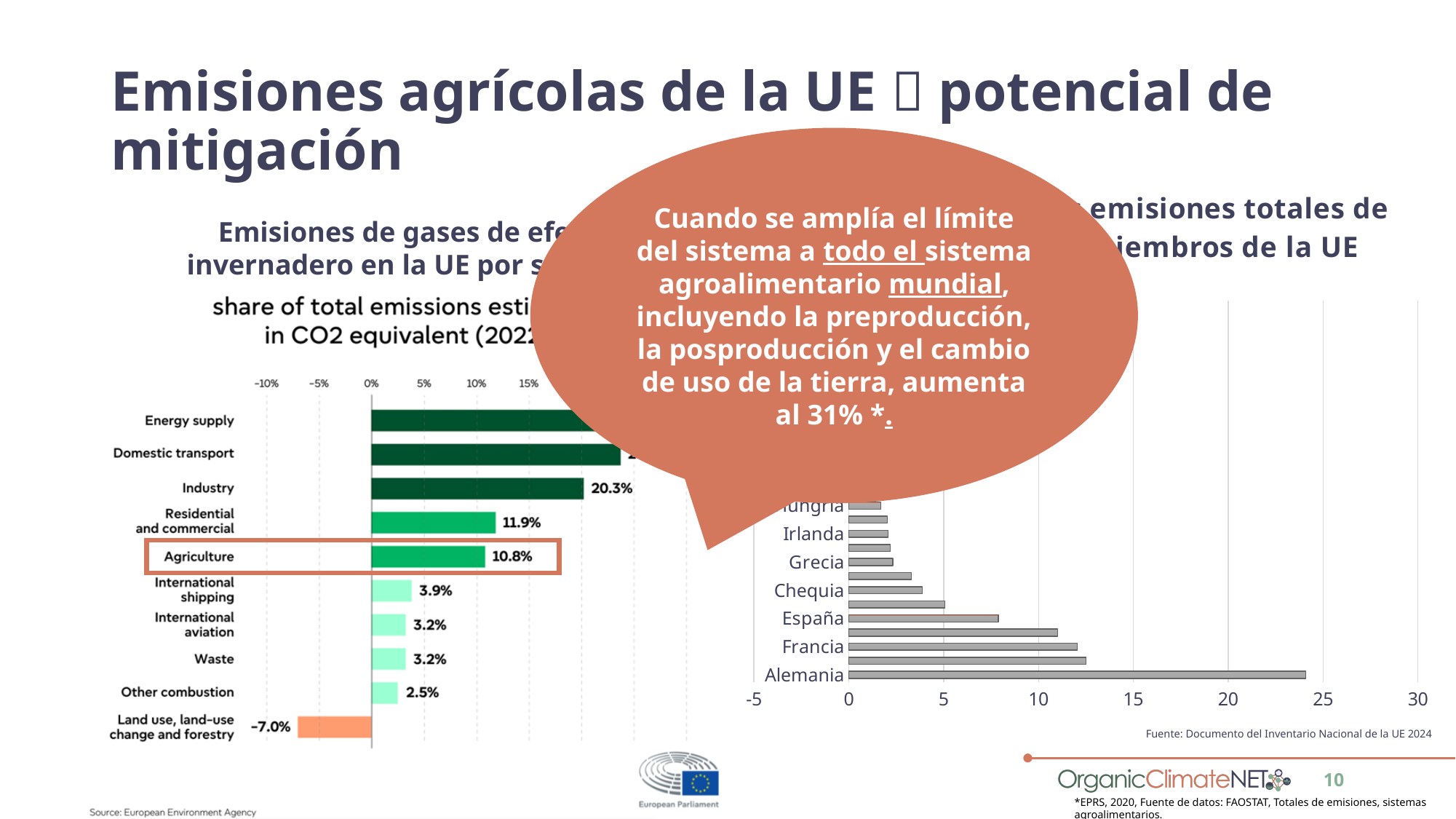
In the left chart, what is the difference between the Industry value and the Agriculture value? 9.5 percentage points In the left chart, which category has the lowest value? Land use, land-use change and forestry In the left chart, how many sector categories are shown? 10 What kind of chart is the left chart? Bar chart In the left chart, which is larger: Residential and commercial or Agriculture? Residential and commercial In the left chart, what is the value for International shipping? 3.9% In the right chart, is the value for Alemania greater or less than 20? greater In the left chart, what is the value for Residential and commercial? 11.9% In the left chart (Emisiones de gases de efecto invernadero en la UE por sector), what is the value for Industry? 20.3% In the left chart, what is the value for Land use, land-use change and forestry? -7.0% In the right chart (emissions of EU member states), which country has the highest value? Alemania In the left chart, what share of emissions is attributed to Agriculture? 10.8%